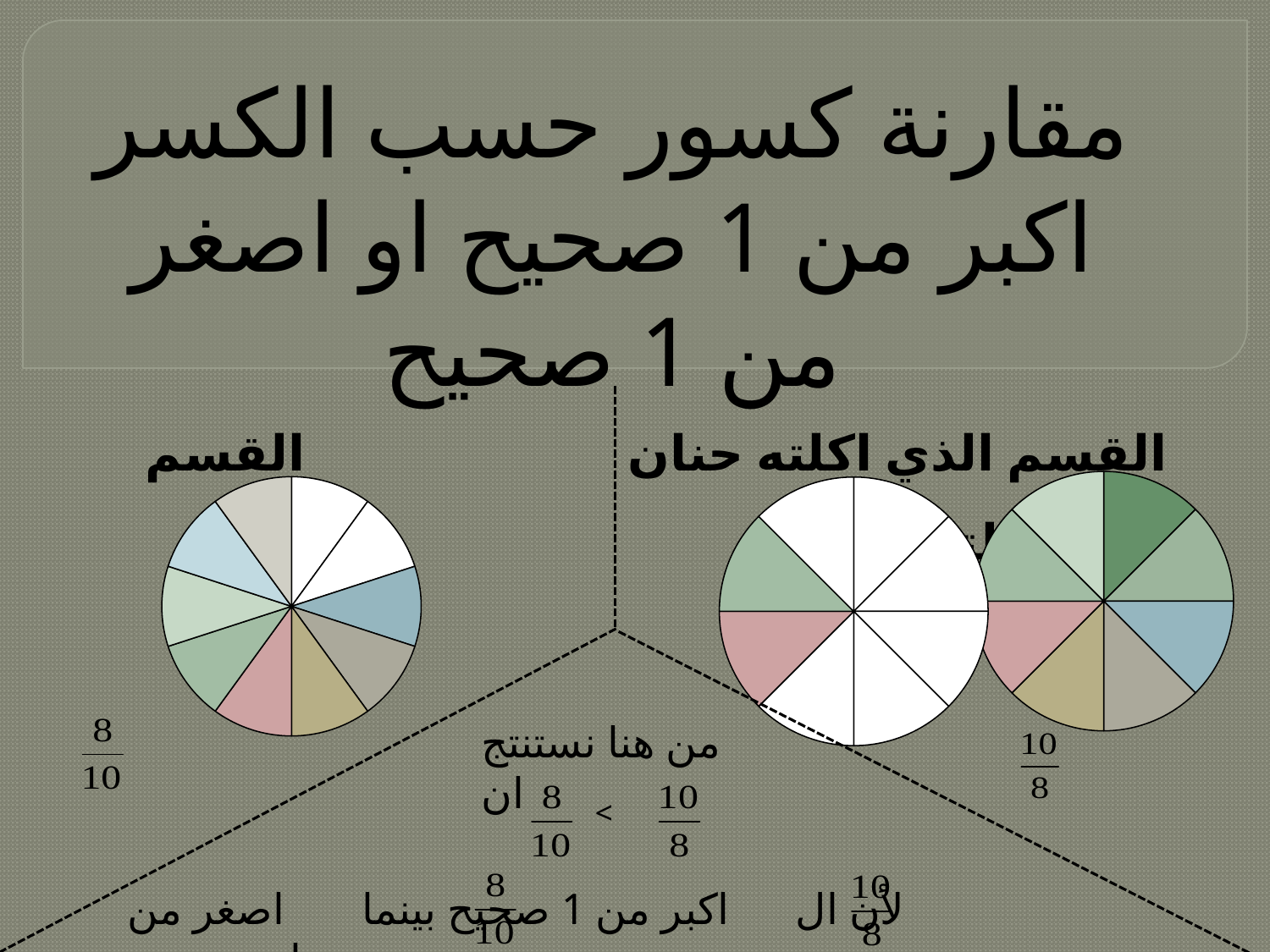
What fraction is written below the right-hand pie charts? 10/8 What fraction is written below the left pie chart? 8/10 What kind of chart is used on this slide to represent the fractions? pie chart How many slices is each of the two right-hand pie charts (labelled 10/8) divided into? 8 Is the fraction represented by the two right-hand pie charts (10/8) greater or less than 1? greater According to the slide, which fraction is larger, 10/8 or 8/10? 10/8 In the left pie chart, how many slices are shaded with colour? 8 How many pie charts are shown on the slide? 3 Is the fraction represented by the left pie chart (8/10) greater or less than 1? less